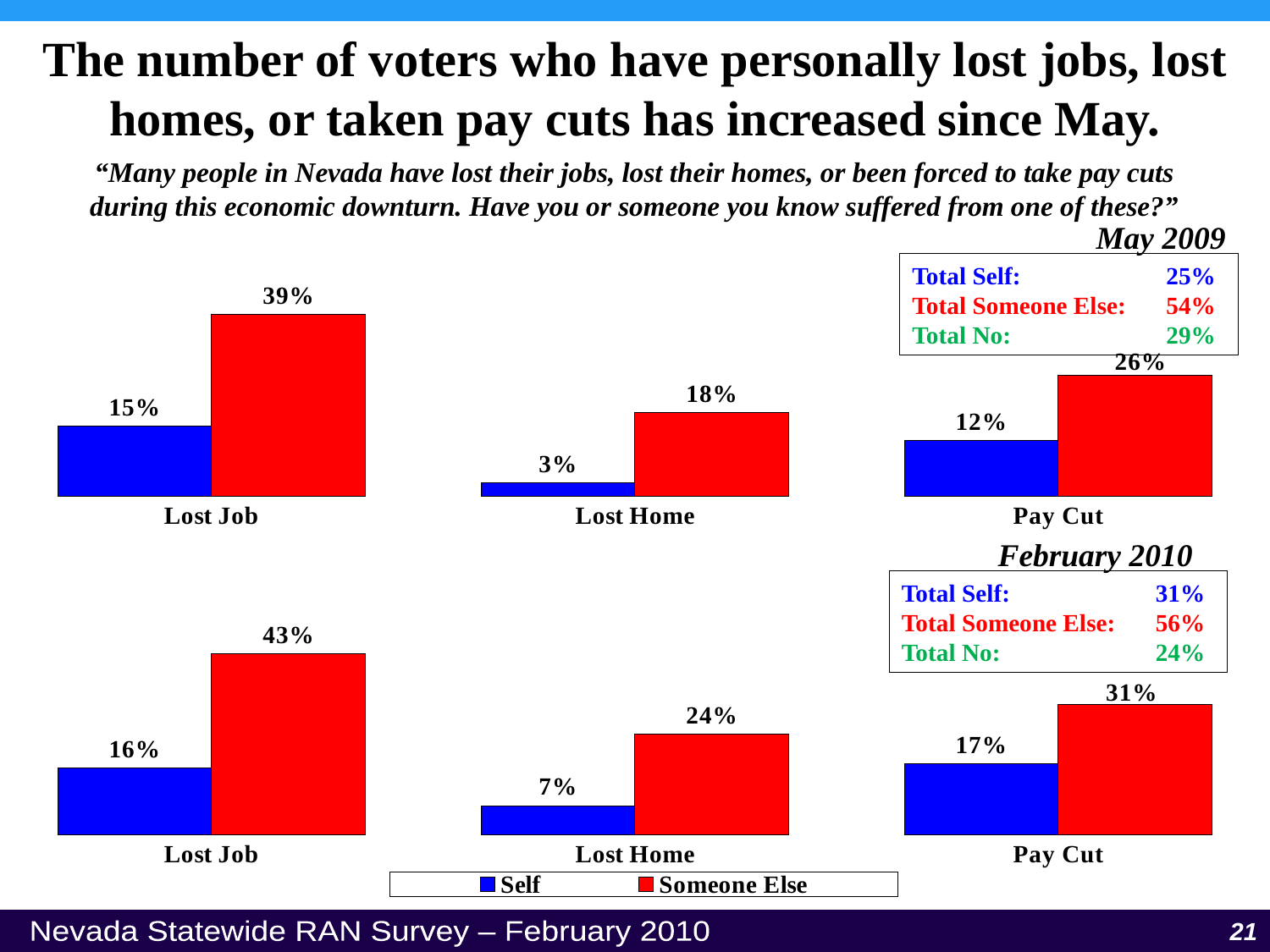
In the May 2009 charts, what is the Someone Else value for Pay Cut? 26% What colour represents the Someone Else series in the legend? Red In the February 2010 charts, what is the Self value for Pay Cut? 17% In the May 2009 charts, what percentage of voters said they personally lost a job (Self)? 15% Across the May 2009 charts, which category has the lowest Self value? Lost Home Across the February 2010 charts, which category has the highest Someone Else value? Lost Job What type of chart is used on this slide? Bar chart In the February 2010 Lost Job chart, what is the difference between the Someone Else and Self values? 27% Which is larger: the Someone Else value for Pay Cut in May 2009 or in February 2010? February 2010 How many series does the legend list? 2 How much did the Self value for Lost Home change from May 2009 to February 2010? 4% In the February 2010 charts, what is the Someone Else value for Lost Home? 24%